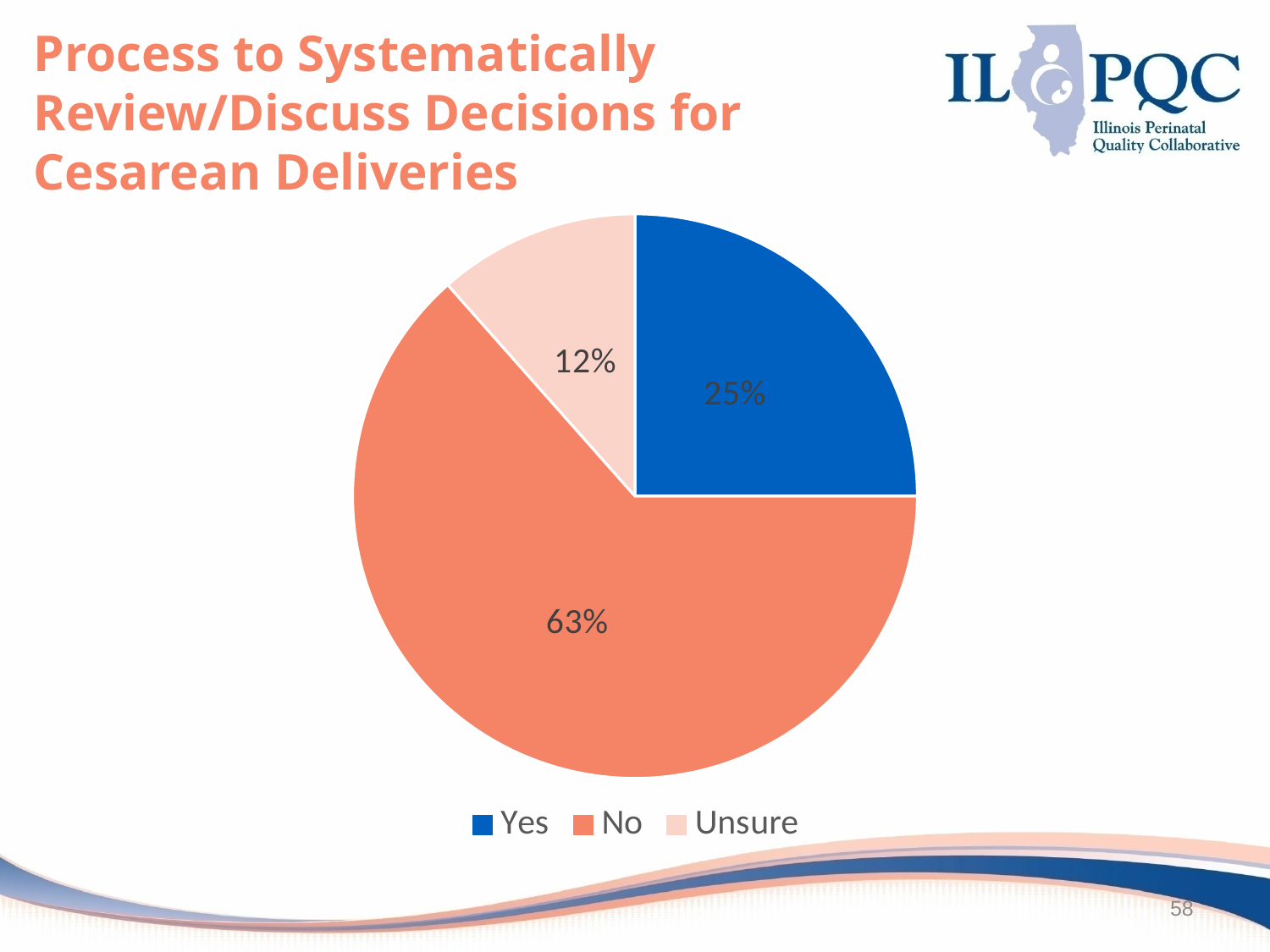
What kind of chart is shown on the slide? pie chart What is the difference in percentage points between the "Yes" slice and the "Unsure" slice? 13 What percentage of the pie is labelled "Yes"? 25% What percentage of the pie is labelled "No"? 63% What is the title of the slide containing the pie chart? Process to Systematically Review/Discuss Decisions for Cesarean Deliveries Which slice is larger, "Yes" or "Unsure"? Yes What percentage of the pie is labelled "Unsure"? 12% Which category has the smallest slice of the pie? Unsure Which category has the largest slice of the pie? No What colour is the "No" slice of the pie? orange What is the difference in percentage points between the "No" slice and the "Yes" slice? 38 How many categories does the legend list? 3